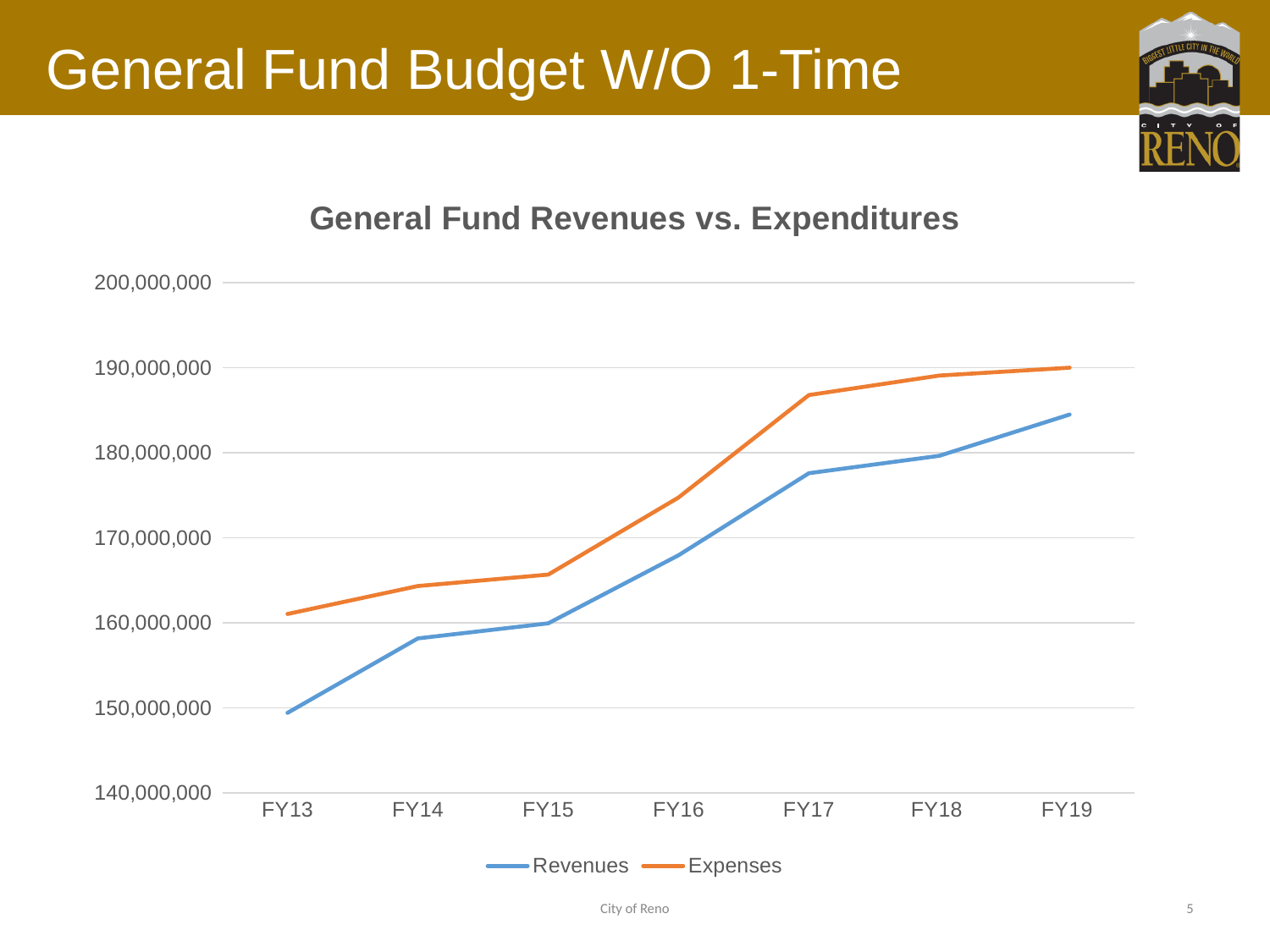
Is the Expenses value for FY17 greater or less than 180,000,000? greater How many fiscal years are plotted along the x axis? 7 Do the Revenues values rise or fall from FY13 to FY19? rise In which fiscal year are Revenues lowest? FY13 In FY17, which is larger, Revenues or Expenses? Expenses What kind of chart is shown on the slide? line chart How many series does the legend list? 2 In which fiscal year are Expenses highest? FY19 Is the Revenues value for FY14 greater or less than 160,000,000? less Is the Expenses value for FY16 greater or less than 170,000,000? greater What is the title of the chart? General Fund Revenues vs. Expenditures